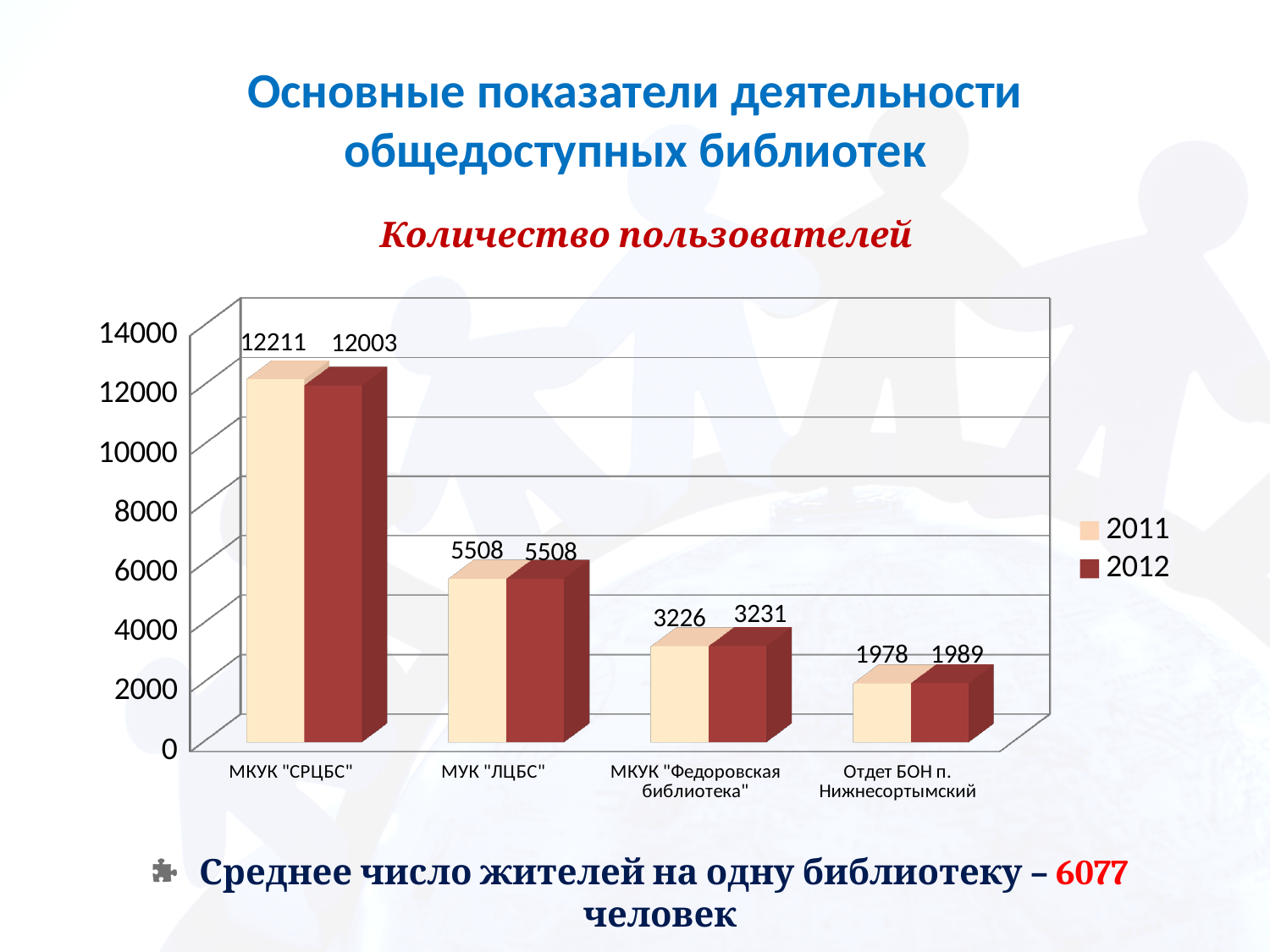
What is the 2012 value for Отдет БОН п. Нижнесортымский? 1989 Which category has the lowest value in the 2011 series? Отдет БОН п. Нижнесортымский Is the 2011 value for МУК "ЛЦБС" greater or less than 6000? less How many categories are shown on the x axis? 4 Which is larger for МКУК "Федоровская библиотека": the 2011 value or the 2012 value? 2012 What kind of chart is shown on the slide? bar chart What is the difference between the 2011 and 2012 values for МКУК "СРЦБС"? 208 Which category has the highest value in the 2012 series? МКУК "СРЦБС" What is the 2011 value for МКУК "СРЦБС"? 12211 What is the title of the chart? Количество пользователей What is the 2012 value for МКУК "Федоровская библиотека"? 3231 How many series does the legend list? 2